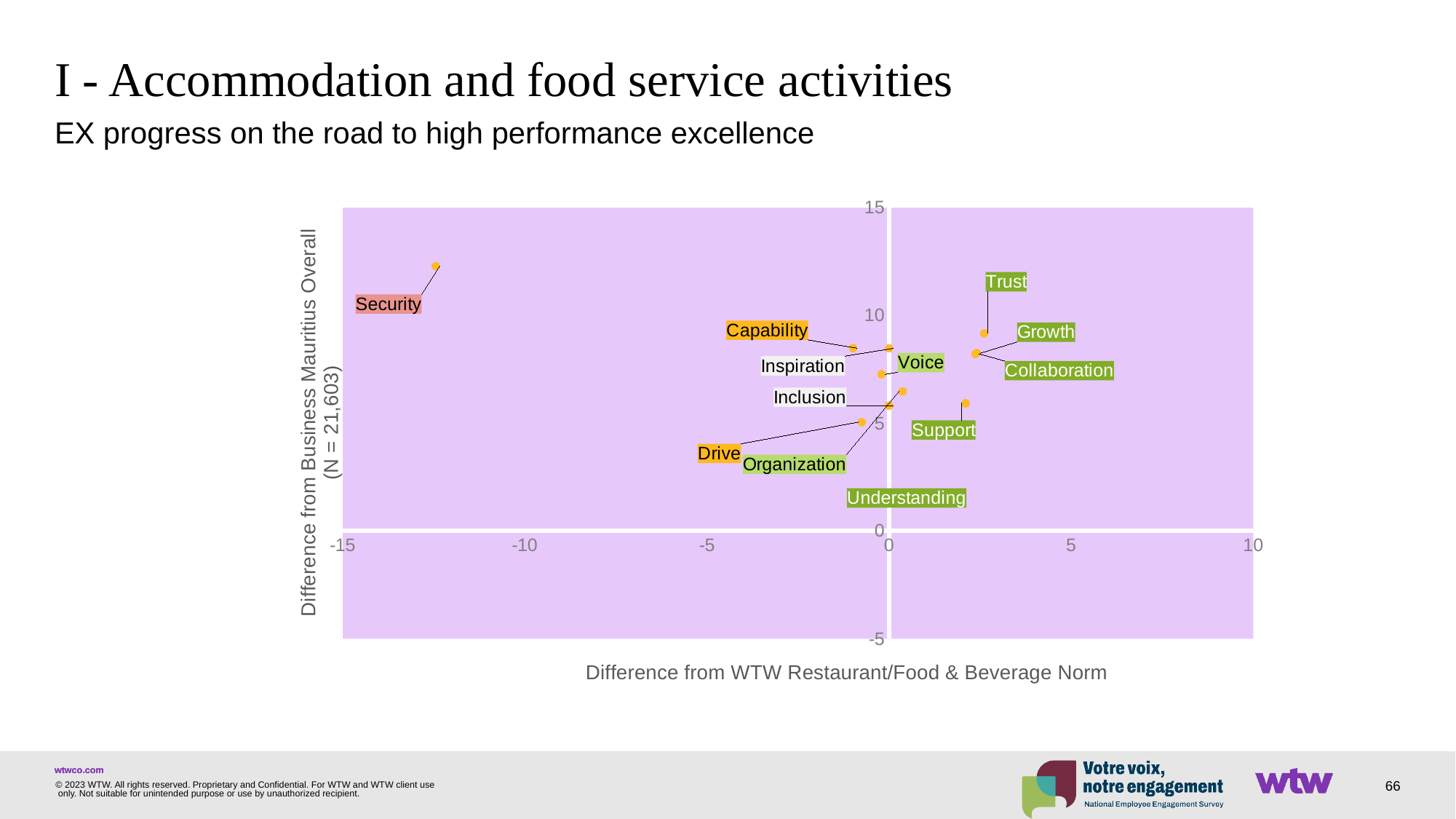
How many labelled points are plotted on the chart? 12 Is the vertical-axis value for Support greater or less than 10? less Which labelled point is furthest to the left on the chart? Security What is the title of the horizontal axis of the chart? Difference from WTW Restaurant/Food & Beverage Norm What is the title of the vertical axis of the chart? Difference from Business Mauritius Overall (N = 21,603) Is the horizontal-axis value for Security greater or less than -10? less What kind of chart is shown on the slide? scatter chart Is the vertical-axis value for Trust greater or less than 5? greater Which labelled point has the highest value on the vertical axis? Security Which has the higher vertical-axis value, Security or Trust? Security